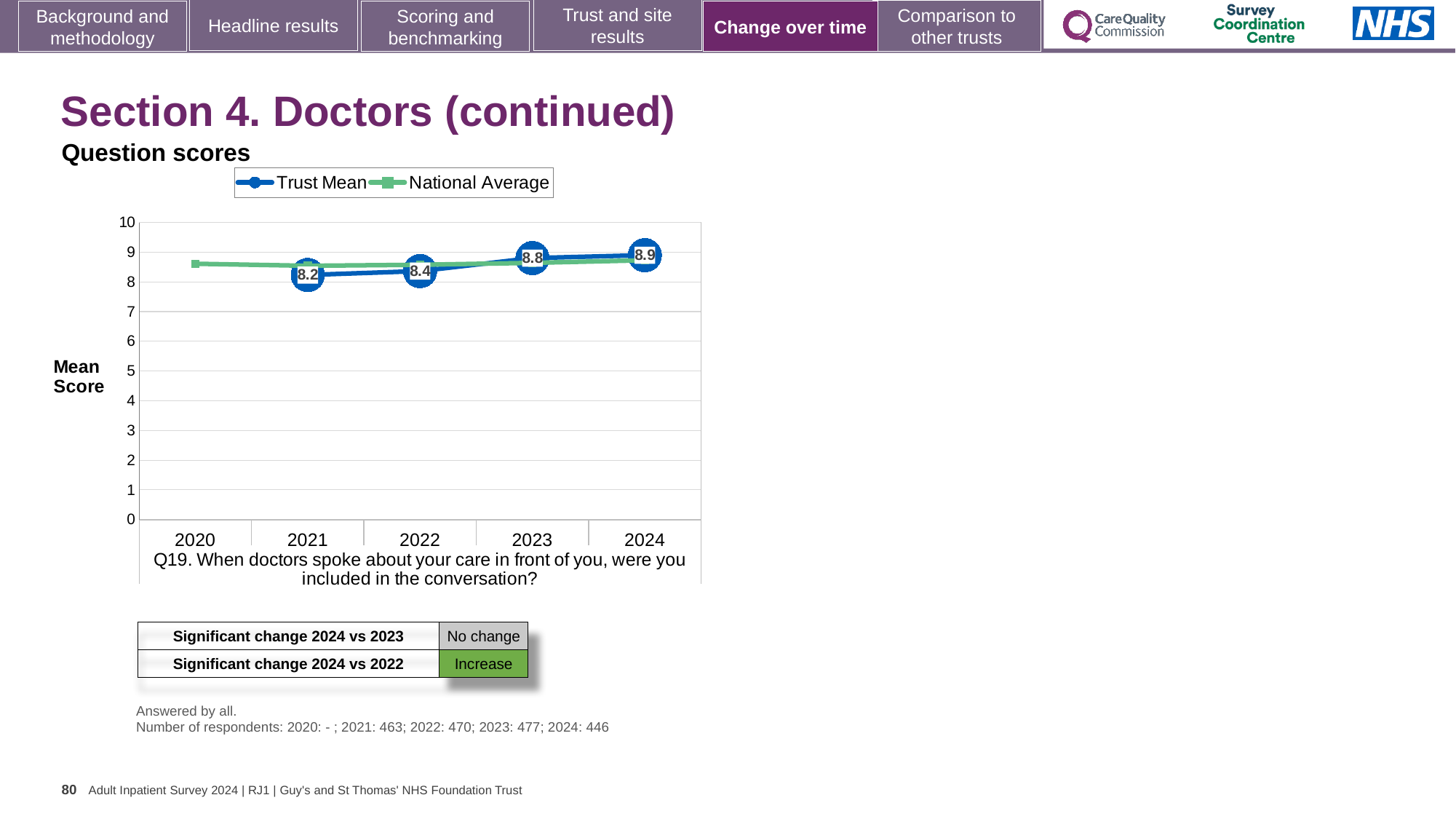
What is the difference between the Trust Mean scores for 2024 and 2021? 0.7 What is the Trust Mean score for 2024? 8.9 In 2021, which is higher, the Trust Mean or the National Average? National Average What is the Trust Mean score for 2022? 8.4 What is the Trust Mean score for 2021? 8.2 What kind of chart is shown on the slide? line chart Which is larger, the Trust Mean score for 2023 or for 2022? 2023 Does the Trust Mean rise or fall from 2021 to 2024? rise How many series does the legend list? 2 In which year is the Trust Mean score lowest? 2021 In which year is the Trust Mean score highest? 2024 Is the National Average value for 2020 greater or less than 8? greater